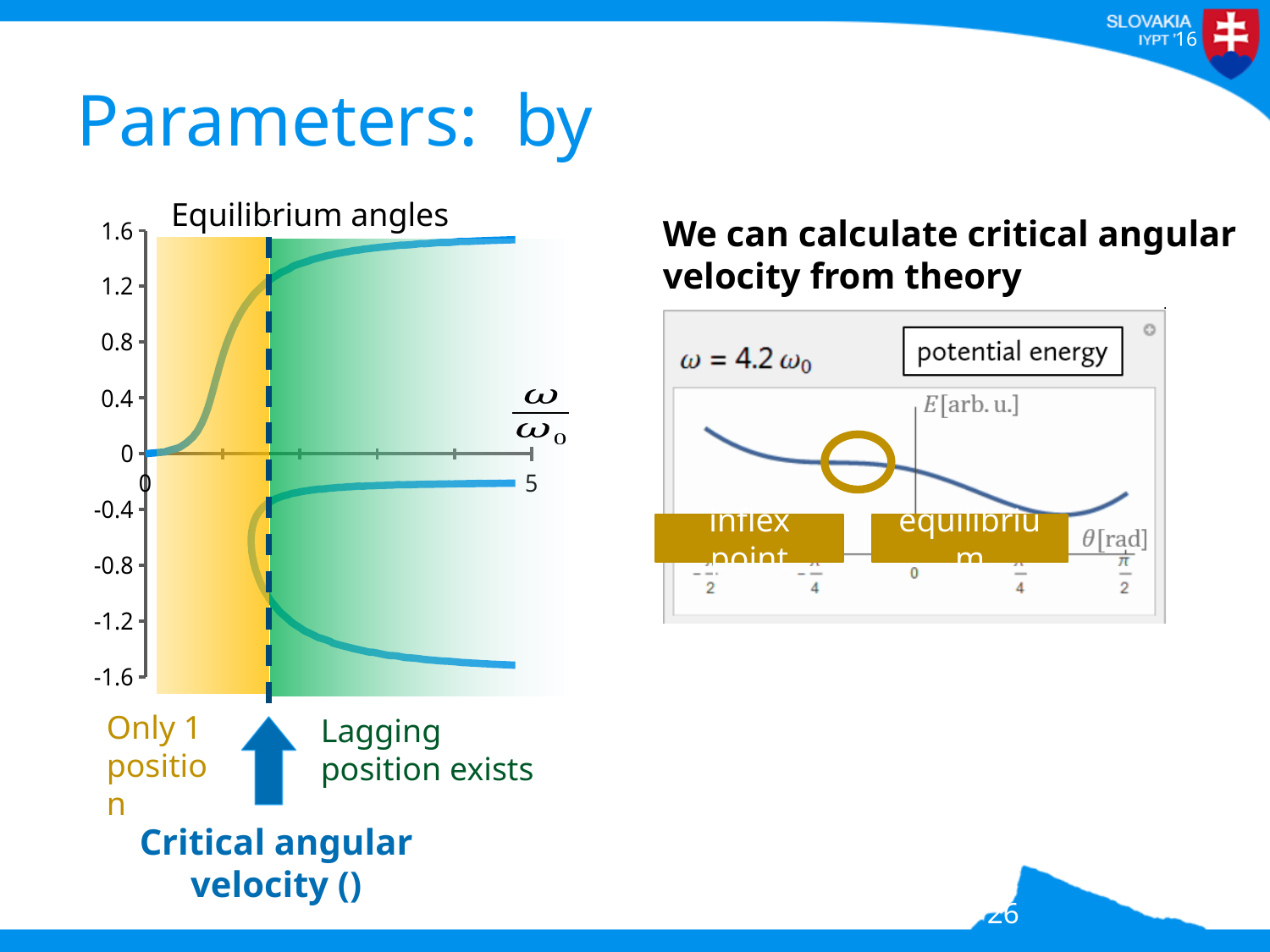
In the 'Equilibrium angles' chart, does the upper curve rise or fall as the x axis value increases? rise In the 'potential energy' chart on the right, what is the label of the x axis? θ [rad] In the 'potential energy' chart on the right, what value of ω is stated? 4.2 ω0 In the 'Equilibrium angles' chart, what is the highest value shown on the y axis? 1.6 What is the title of the chart on the left of the slide? Equilibrium angles In the 'Equilibrium angles' chart, what is the lowest value shown on the y axis? -1.6 In the 'Equilibrium angles' chart, is the value of the upper curve at x = 5 greater or less than 1.2? greater In the 'Equilibrium angles' chart, what is the largest value labelled on the x axis? 5 In the 'Equilibrium angles' chart, is the value of the lowest curve at x = 5 greater or less than -1.2? less In the 'Equilibrium angles' chart, how many tick labels are printed on the y axis? 9 What kind of chart is the 'Equilibrium angles' chart? line chart In the 'potential energy' chart on the right, is the value of the curve at θ = -π/2 greater or less than the value at θ = π/4? greater